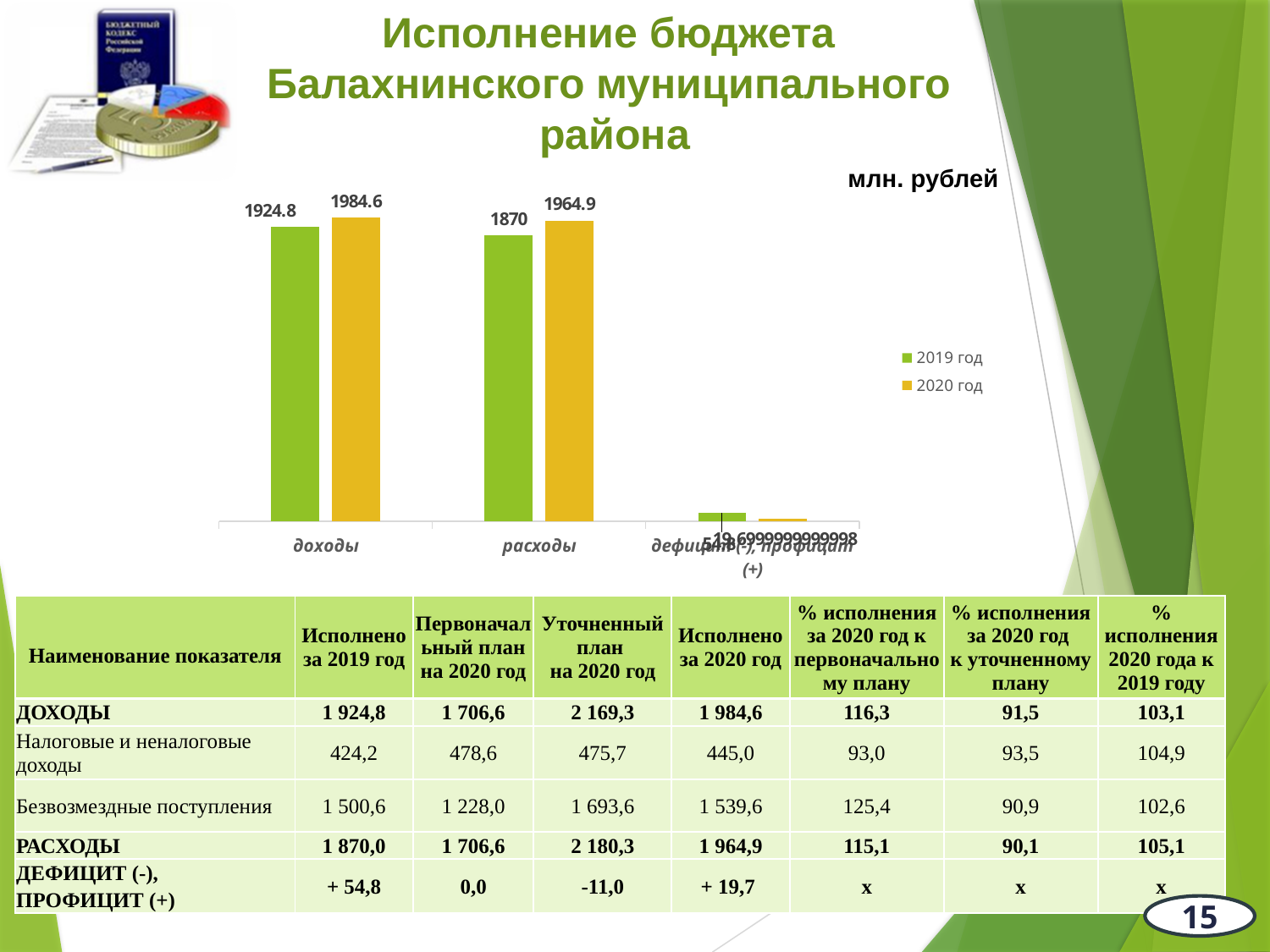
What is the value for доходы in the 2019 год series? 1924.8 Which category has the highest value in the 2020 год series? доходы What is the difference between the 2020 год and 2019 год values for расходы? 94.9 Which category has the lowest values in the chart? дефицит(-), профицит(+) How many categories are shown on the x axis of the chart? 3 What is the value for расходы in the 2020 год series? 1964.9 What is the value for расходы in the 2019 год series? 1870 What is the difference between the 2020 год and 2019 год values for доходы? 59.8 How many series does the legend list? 2 Which is larger: доходы in 2019 год or расходы in 2019 год? доходы in 2019 год What kind of chart is shown on the slide? bar chart What is the value for доходы in the 2020 год series? 1984.6